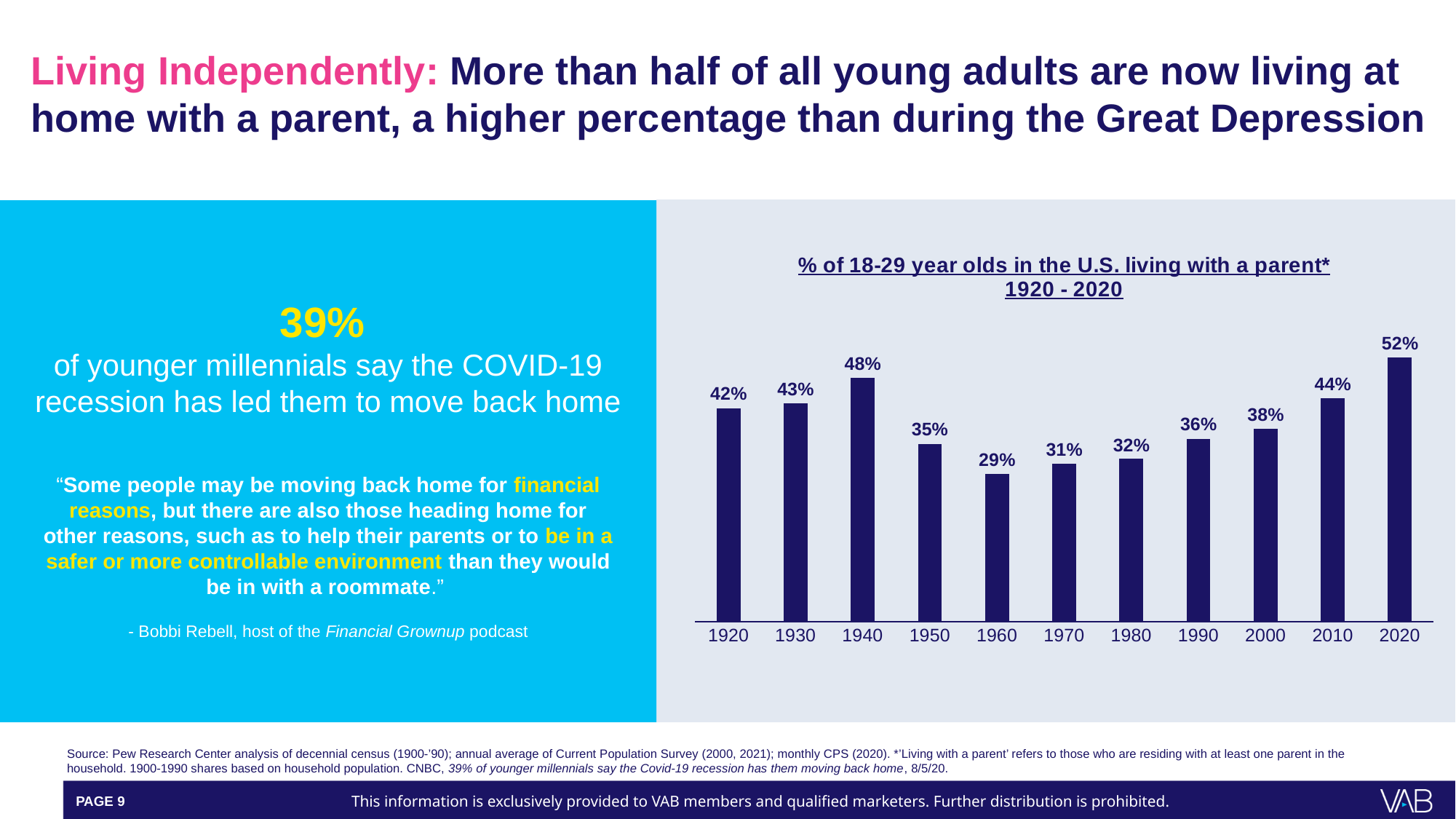
What is the title of the chart? % of 18-29 year olds in the U.S. living with a parent* 1920 - 2020 What is the difference between the 2020 value and the 1940 value? 4% What percentage is shown for 1940? 48% What kind of chart is shown on the slide? Bar chart What value is shown for 1960 in the chart? 29% Do the values rise or fall from 1960 to 2020? Rise What percentage of 18-29 year olds in the U.S. were living with a parent in 2020? 52% Which year has a higher value, 1950 or 1990? 1990 How many years are shown on the x axis of the chart? 11 Which year has the lowest percentage of 18-29 year olds living with a parent? 1960 What is the difference between the 1920 value and the 1960 value? 13% Which year has the highest percentage of 18-29 year olds living with a parent? 2020